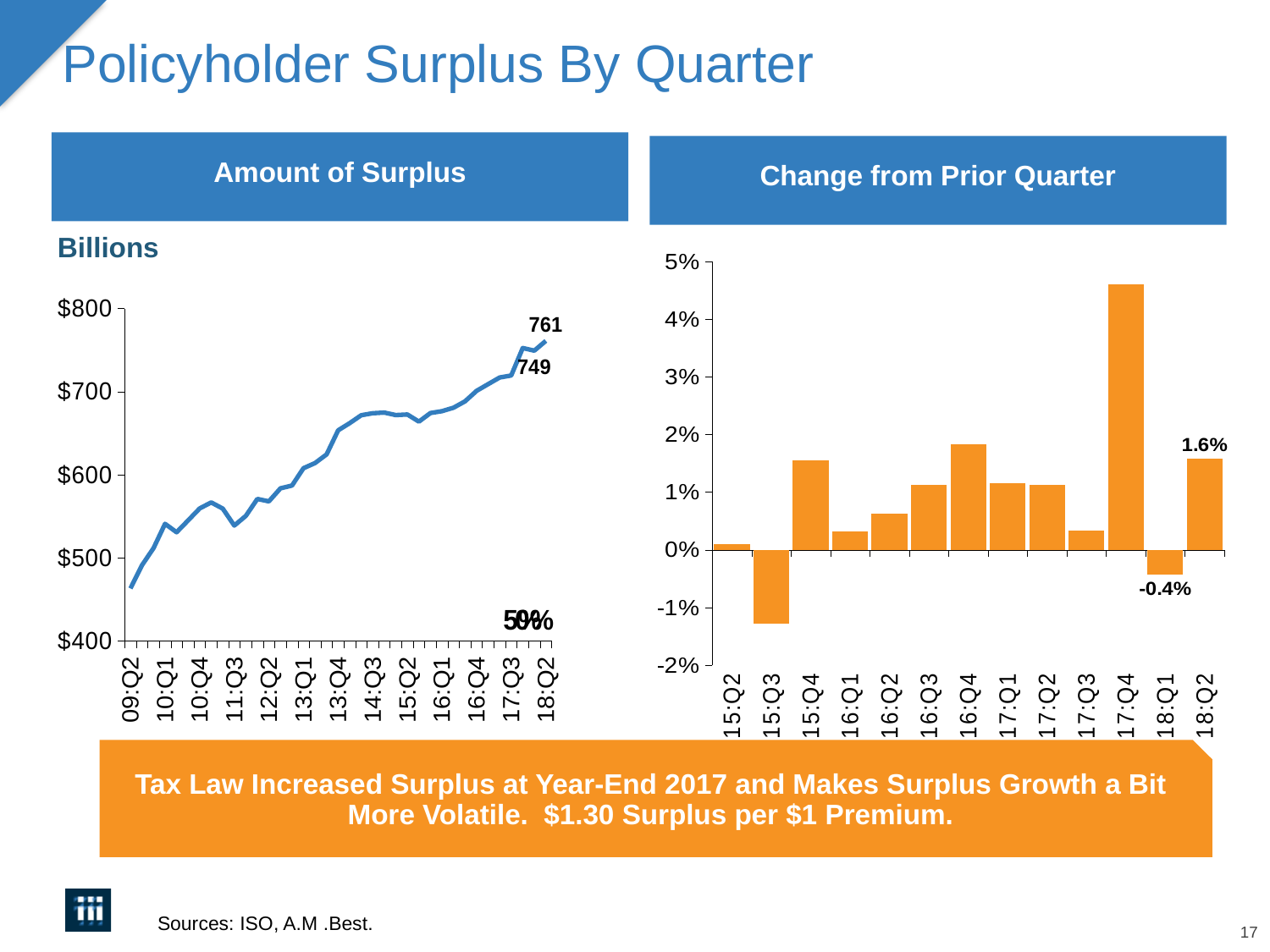
On the 'Change from Prior Quarter' chart, what is the labeled value for 18:Q1? -0.4% On the 'Change from Prior Quarter' chart, is the value for 17:Q4 greater or less than 4%? greater What kind of chart is the 'Change from Prior Quarter' chart? Bar chart On the 'Change from Prior Quarter' chart, is the value for 15:Q3 greater or less than -1%? less On the 'Change from Prior Quarter' chart, which is larger, the value for 18:Q2 or the value for 18:Q1? 18:Q2 On the 'Change from Prior Quarter' chart, what is the labeled value for 18:Q2? 1.6% On the 'Change from Prior Quarter' chart, which quarter has the lowest change? 15:Q3 On the 'Amount of Surplus' chart, what is the labeled value for 18:Q2? 761 On the 'Change from Prior Quarter' chart, which quarter has the highest change? 17:Q4 On the 'Amount of Surplus' chart, is the value for 09:Q2 greater or less than $500? less How many quarters are shown on the 'Change from Prior Quarter' chart? 13